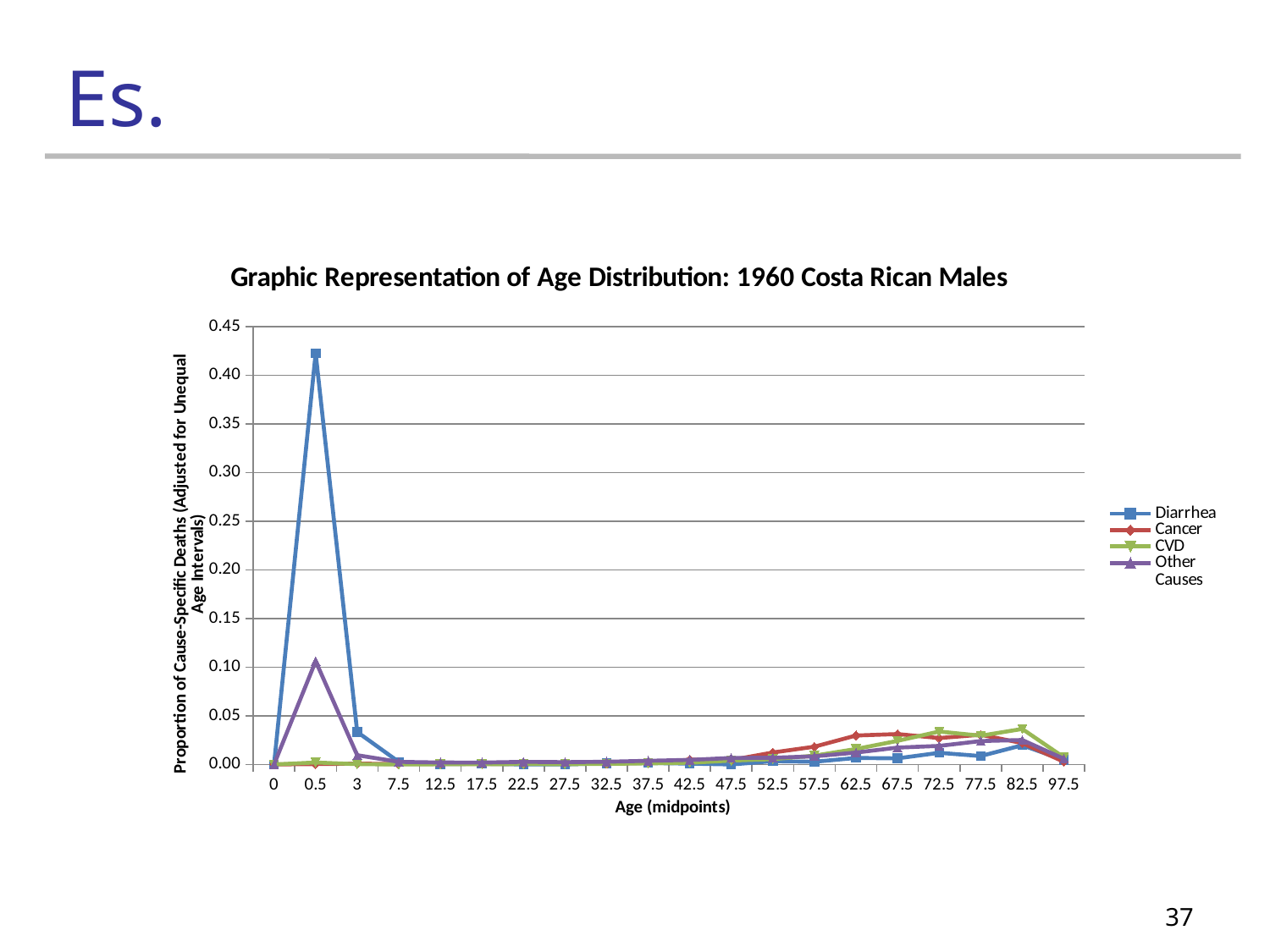
Is the value for Diarrhea at age 0.5 greater or less than 0.40? greater What is the label of the x axis? Age (midpoints) At which age midpoint does the Diarrhea series reach its highest value? 0.5 Is the value for Diarrhea at age 3 greater or less than 0.05? less Is the value for Other Causes at age 0.5 greater or less than 0.05? greater At age 0.5, which is larger: Diarrhea or Other Causes? Diarrhea How many series does the legend list? 4 What kind of chart is shown on the slide? Line chart Which series reaches the highest value anywhere on the chart? Diarrhea What is the title of the chart? Graphic Representation of Age Distribution: 1960 Costa Rican Males Does the Diarrhea series rise or fall between age 0.5 and age 7.5? Fall How many age midpoints are plotted along the x axis? 20